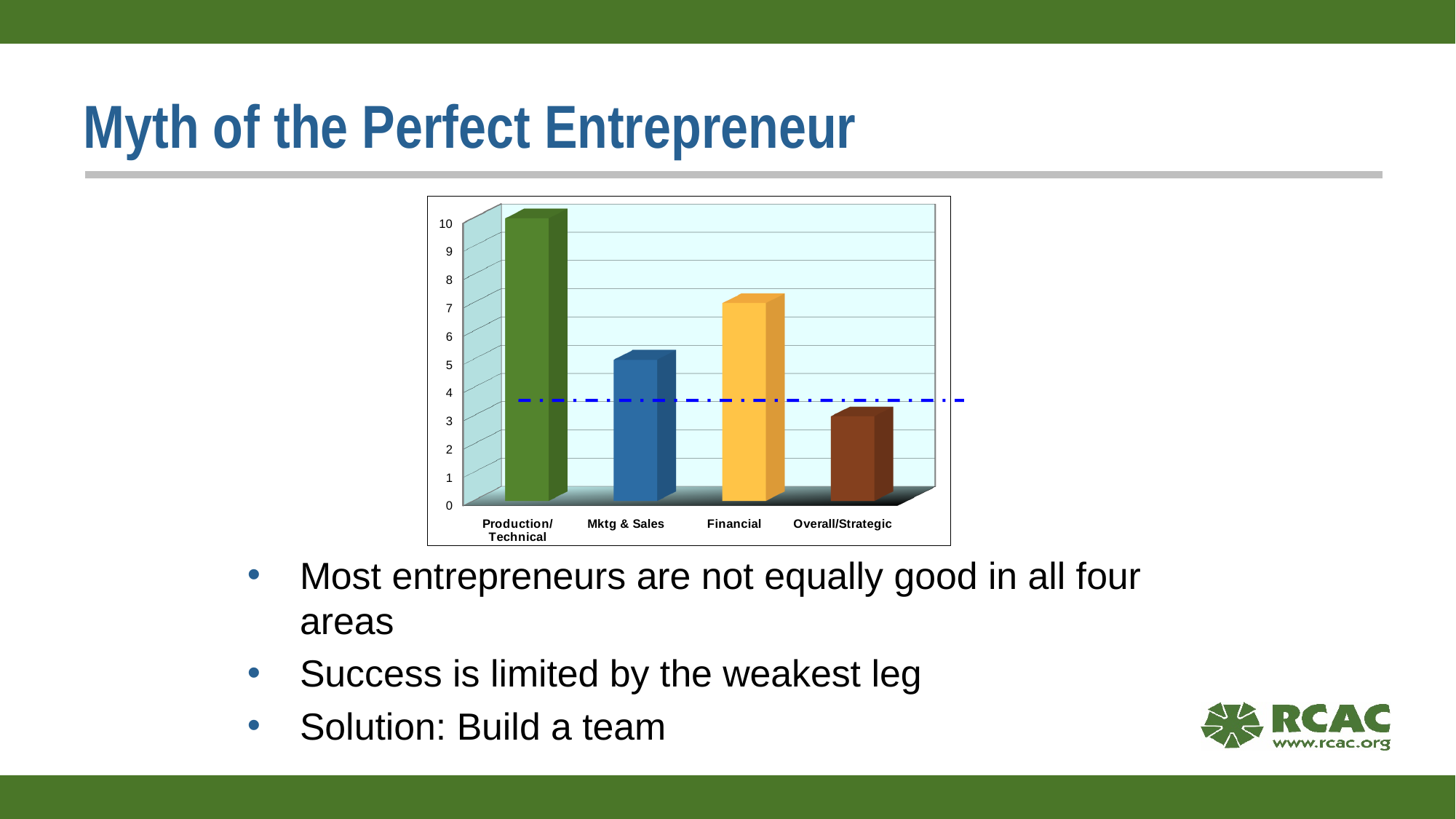
Which category has the highest bar in the chart? Production/Technical Which category has the lowest bar in the chart? Overall/Strategic Which is larger, the value for Mktg & Sales or the value for Overall/Strategic? Mktg & Sales Is the value for Overall/Strategic greater or less than 4? less Is the value for Financial greater or less than 6? greater How many categories are shown on the x axis of the chart? 4 What is the highest value shown on the chart's vertical axis? 10 Which is larger, the value for Financial or the value for Mktg & Sales? Financial What kind of chart is shown on the slide? bar chart What is the value for Production/Technical? 10 What colour is the bar for Financial? yellow Is the value for Mktg & Sales greater or less than 6? less